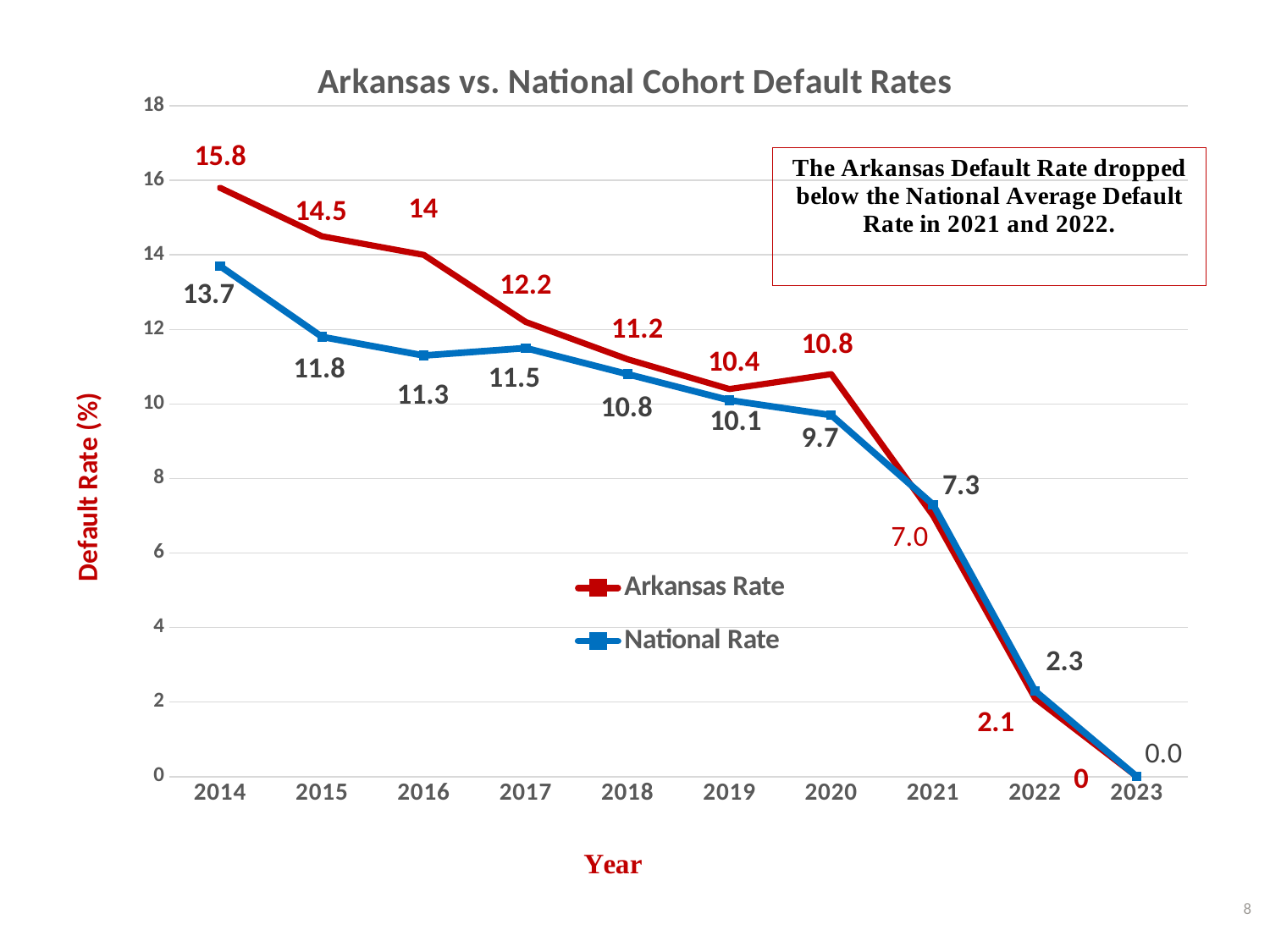
What is the Arkansas Rate in 2021? 7.0 What is the Arkansas Rate in 2014? 15.8 Which is larger in 2021, the Arkansas Rate or the National Rate? National Rate How many series does the legend list? 2 Does the National Rate generally rise or fall from 2014 to 2023? Fall What is the difference between the Arkansas Rate and the National Rate in 2016? 2.7 What is the National Rate in 2016? 11.3 In which year is the National Rate lowest? 2023 In which year is the Arkansas Rate highest? 2014 How many years are plotted on the x axis? 10 What is the National Rate in 2022? 2.3 What type of chart is shown on the slide? Line chart